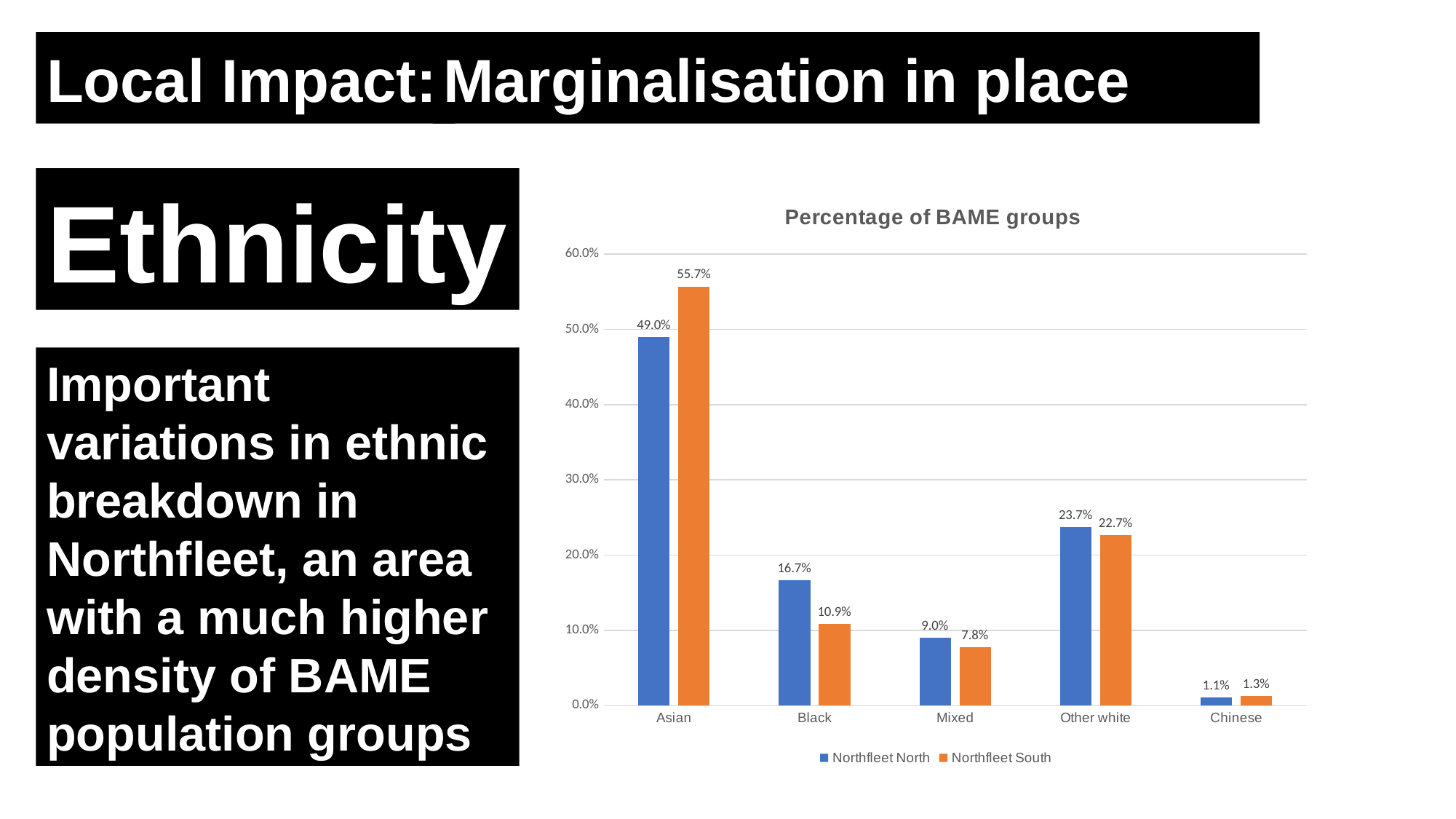
What is the value for Chinese in the Northfleet South series? 1.3% What is the value for Black in the Northfleet North series? 16.7% How many series does the legend list? 2 Which is larger for Other white: Northfleet North or Northfleet South? Northfleet North What is the value for Asian in the Northfleet South series? 55.7% What is the title of the chart? Percentage of BAME groups Which category has the lowest value in the Northfleet South series? Chinese How many categories are shown on the x axis? 5 Which category has the highest value in the Northfleet North series? Asian What is the difference between the Northfleet South and Northfleet North values for Asian? 6.7% Is the Northfleet North value for Mixed greater or less than 10.0%? less What kind of chart is shown on the slide? Bar chart